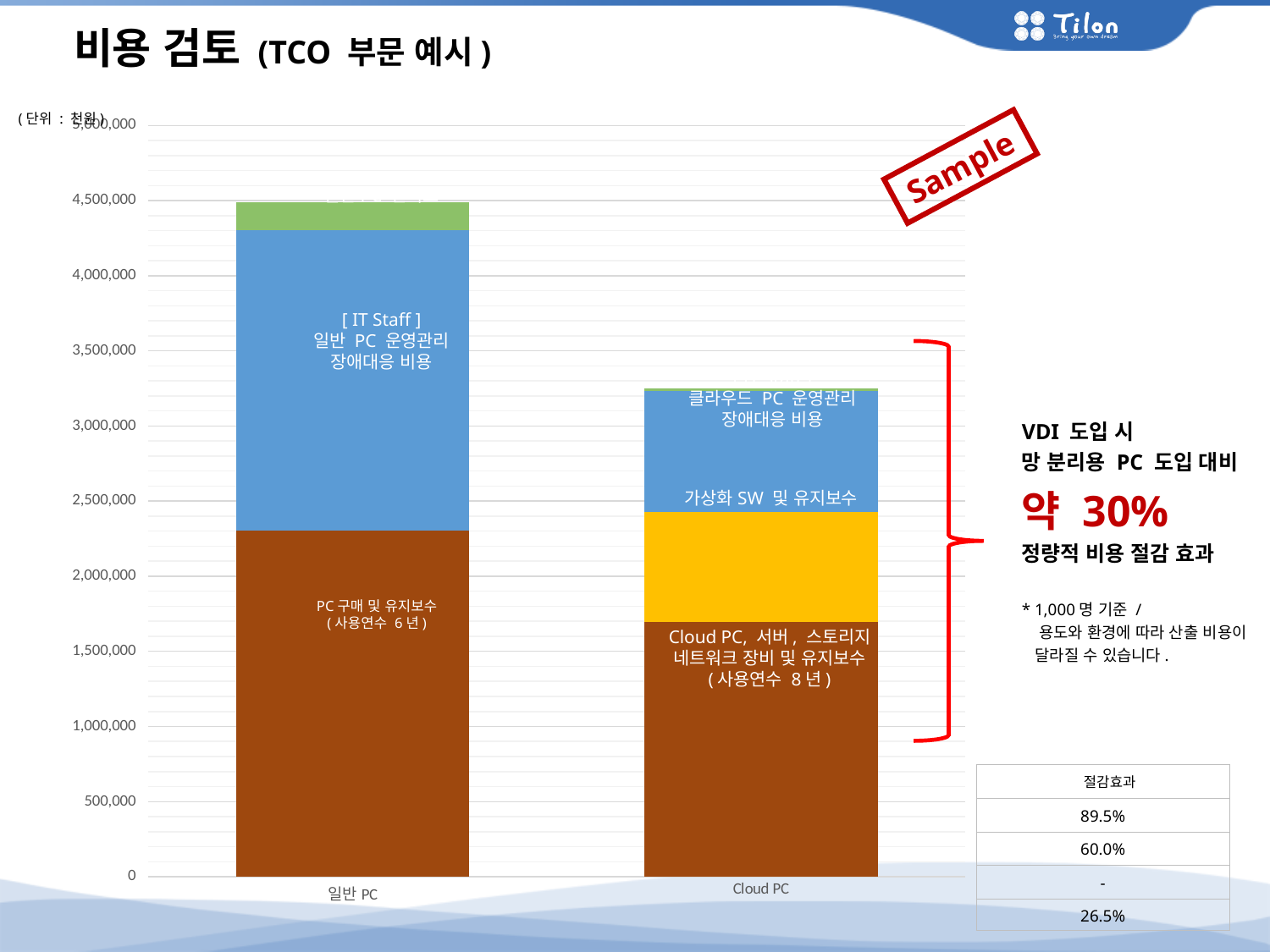
Is the total value of the 일반 PC bar greater or less than 4,000,000? greater Which category has the highest total cost in the chart? 일반 PC Is the top of the brown bottom segment in the Cloud PC bar greater or less than 1,500,000? greater How many categories are shown on the x axis of the chart? 2 Is the total value of the Cloud PC bar greater or less than 3,000,000? greater Which category has the lowest total cost in the chart? Cloud PC Which bar is taller, 일반 PC or Cloud PC? 일반 PC What is the label of the yellow segment in the Cloud PC bar? 가상화 SW 및 유지보수 How many stacked segments make up the Cloud PC bar? 4 What kind of chart is shown on the slide? stacked bar chart